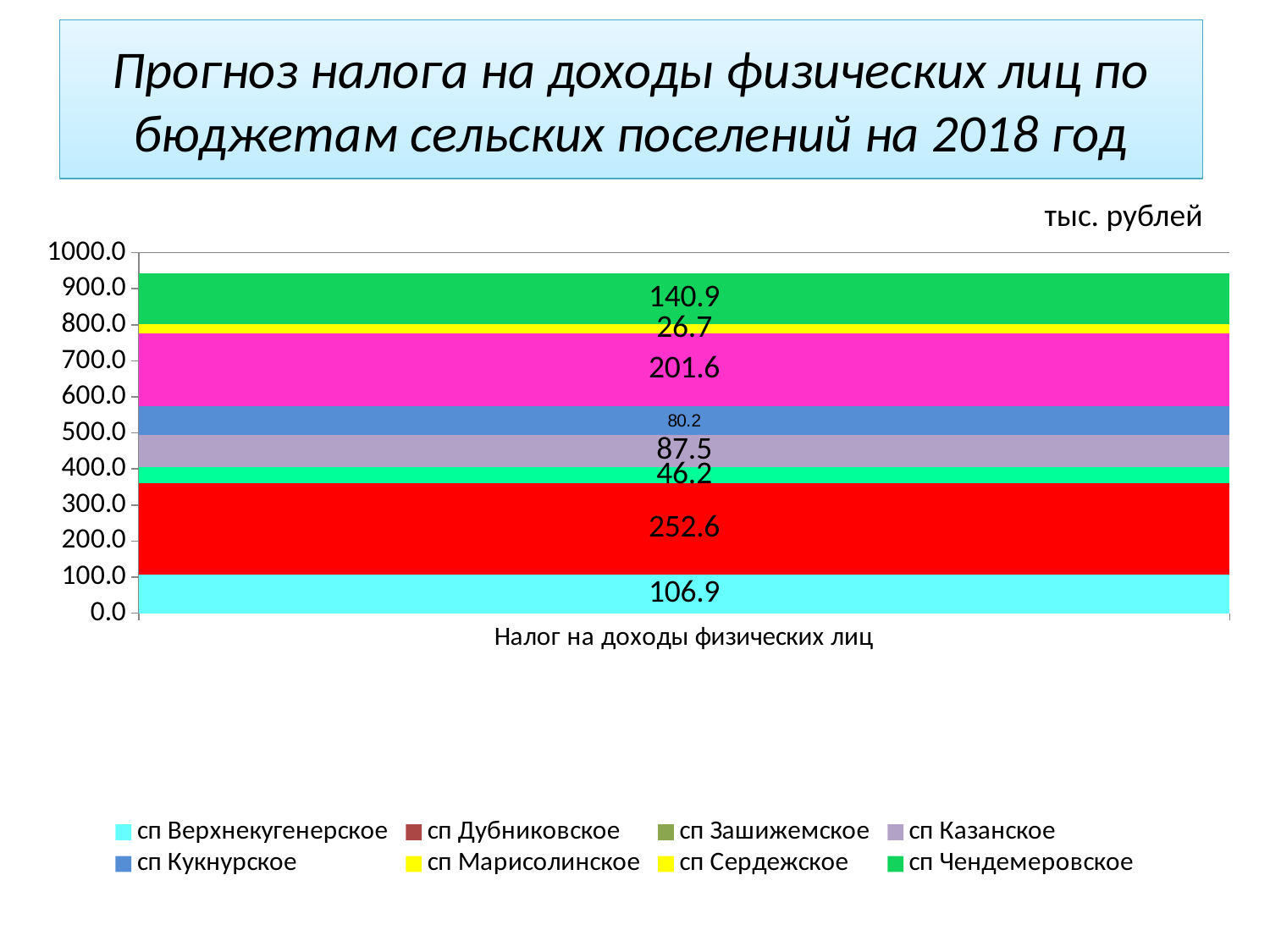
What is the value for сп Кукнурское? 80.2 What is the value for сп Казанское? 87.5 What is the value for сп Чендемеровское? 140.9 What is the total of all segments in the stacked bar? 942.6 What is the difference between the values for сп Чендемеровское and сп Верхнекугенерское? 34.0 Which series has the smallest value in the stacked bar? сп Сердежское How many series does the legend list? 8 What is the value for сп Верхнекугенерское? 106.9 Which segment of the stacked bar has the largest value? сп Дубниковское How many categories are shown on the x axis? 1 What is the value for сп Сердежское? 26.7 What kind of chart is shown on the slide? Stacked bar chart